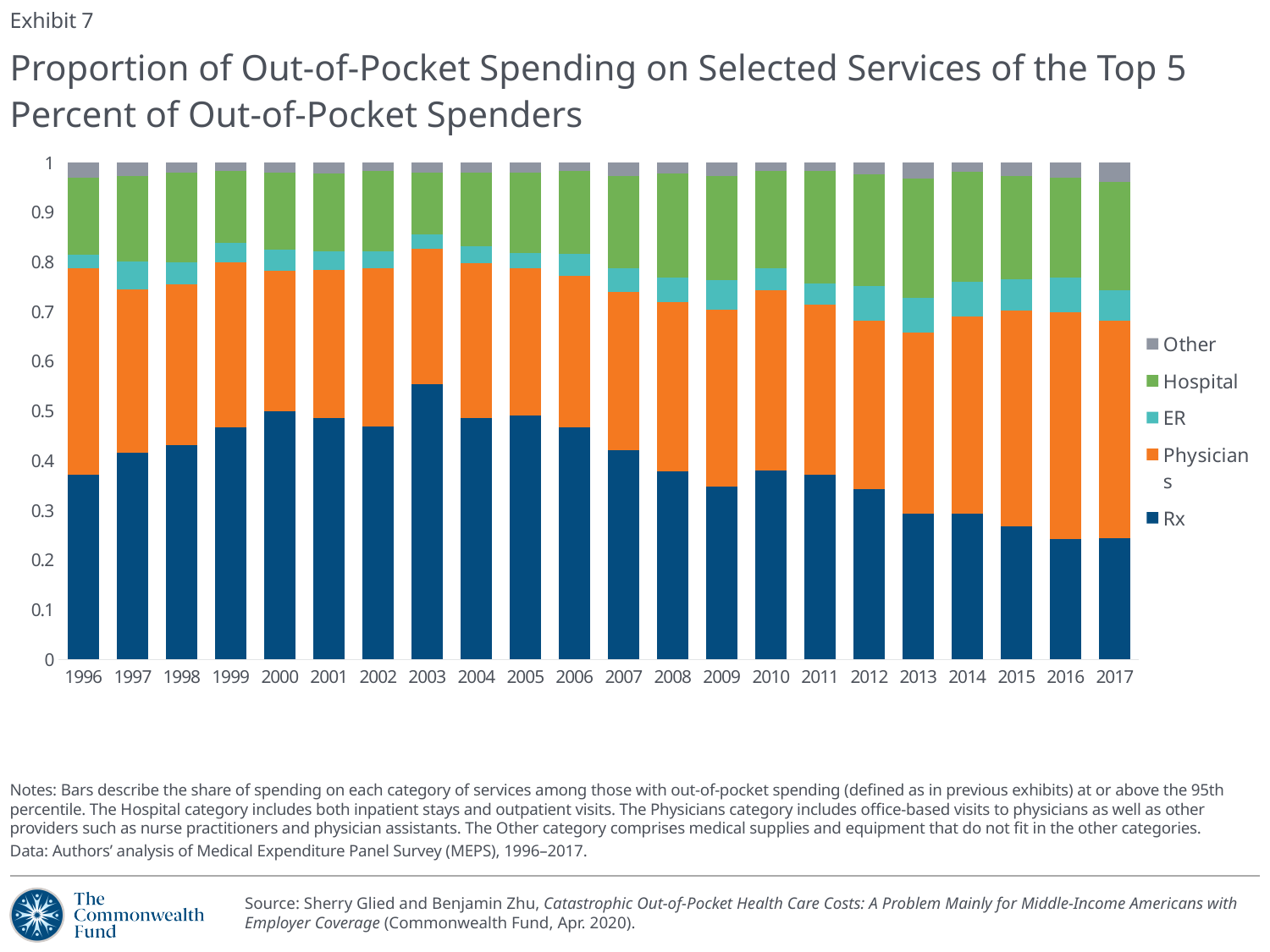
Is the Rx share in 1996 greater or less than 0.4? less How many years are shown along the x axis? 22 How many series does the legend list? 5 Does the Rx share rise or fall from 2003 to 2017? fall Which year has the largest Rx share? 2003 What colour represents the Hospital series? Green Which series is listed last in the legend? Rx Is the Rx share in 2003 greater or less than 0.5? greater Is the Rx share in 2015 greater or less than 0.3? less What kind of chart is shown on the slide? Stacked bar chart What is the total of the stacked bar for 1996? 1